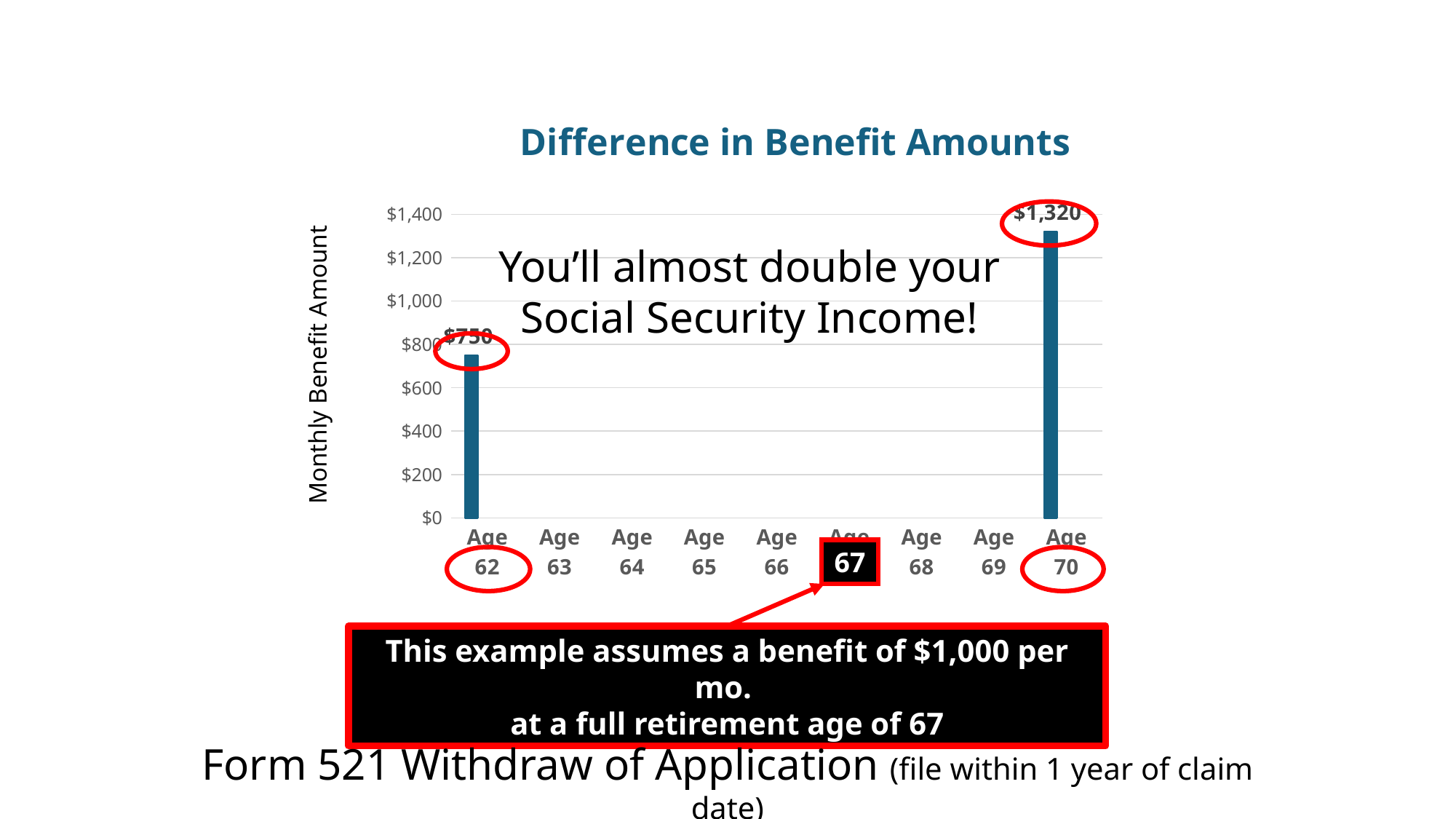
Which of the two plotted bars is larger, Age 62 or Age 70? Age 70 How many age categories are listed along the x axis? 9 Is the value for Age 62 greater or less than $800? less What is the title of the chart? Difference in Benefit Amounts What kind of chart is shown on the slide? bar chart Is the value for Age 70 greater or less than $1,200? greater What is the monthly benefit amount shown for Age 70? $1,320 Is the value for Age 62 greater or less than $600? greater Do the plotted values rise or fall from Age 62 to Age 70? rise Which age has the highest monthly benefit amount in the chart? Age 70 What is the label on the vertical axis of the chart? Monthly Benefit Amount